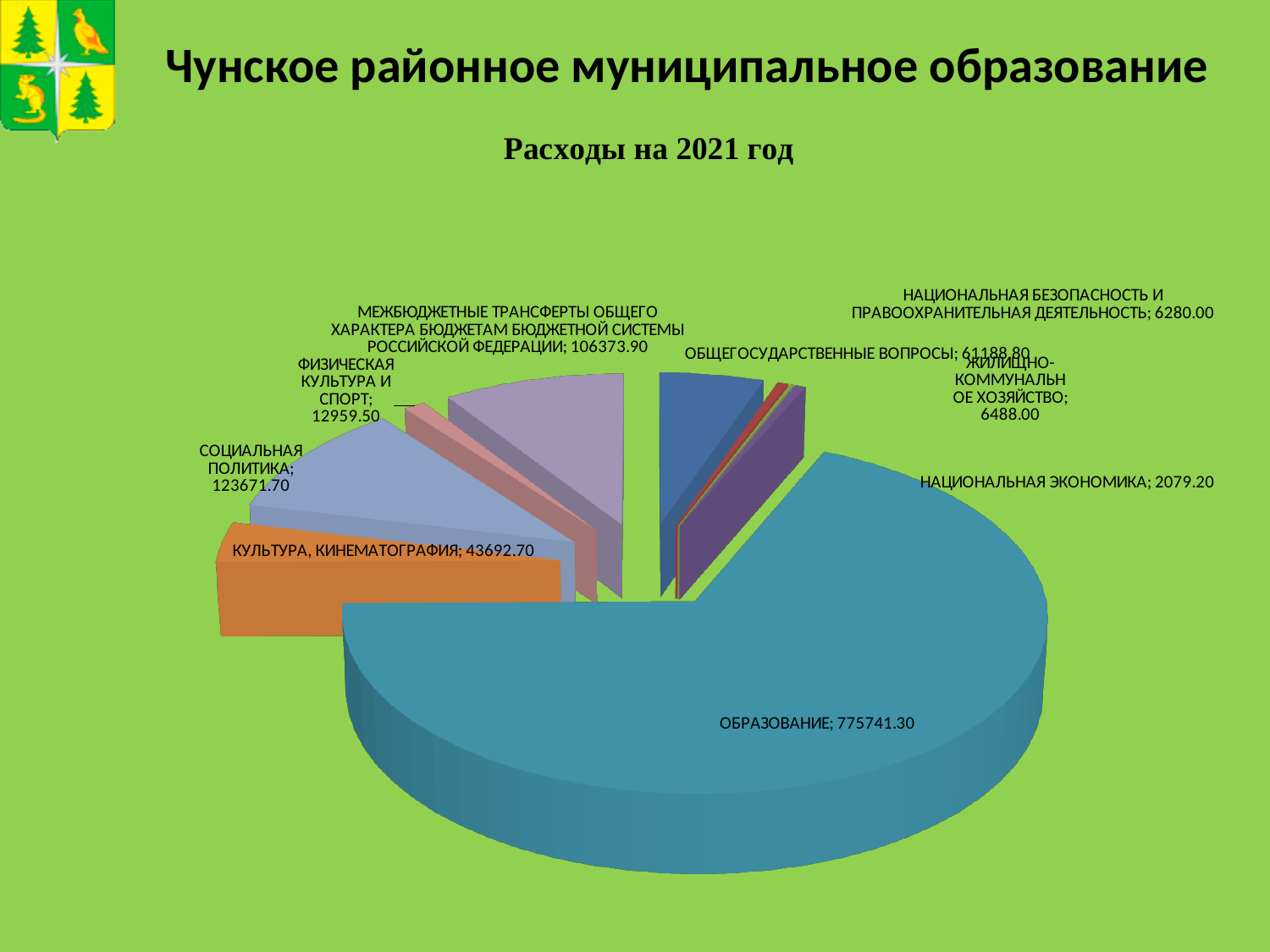
What is the value for ОБРАЗОВАНИЕ? 775741.30 What is the value for НАЦИОНАЛЬНАЯ ЭКОНОМИКА? 2079.20 What is the title of the chart? Расходы на 2021 год How many categories does the pie chart have? 9 Which category has the smallest value? НАЦИОНАЛЬНАЯ ЭКОНОМИКА What is the value for ФИЗИЧЕСКАЯ КУЛЬТУРА И СПОРТ? 12959.50 Which is larger, the value for ЖИЛИЩНО-КОММУНАЛЬНОЕ ХОЗЯЙСТВО or the value for НАЦИОНАЛЬНАЯ БЕЗОПАСНОСТЬ И ПРАВООХРАНИТЕЛЬНАЯ ДЕЯТЕЛЬНОСТЬ? ЖИЛИЩНО-КОММУНАЛЬНОЕ ХОЗЯЙСТВО What is the value for СОЦИАЛЬНАЯ ПОЛИТИКА? 123671.70 What is the value for КУЛЬТУРА, КИНЕМАТОГРАФИЯ? 43692.70 What kind of chart is shown on the slide? pie chart What is the difference between the values for СОЦИАЛЬНАЯ ПОЛИТИКА and МЕЖБЮДЖЕТНЫЕ ТРАНСФЕРТЫ ОБЩЕГО ХАРАКТЕРА БЮДЖЕТАМ БЮДЖЕТНОЙ СИСТЕМЫ РОССИЙСКОЙ ФЕДЕРАЦИИ? 17297.80 Which category has the largest value? ОБРАЗОВАНИЕ